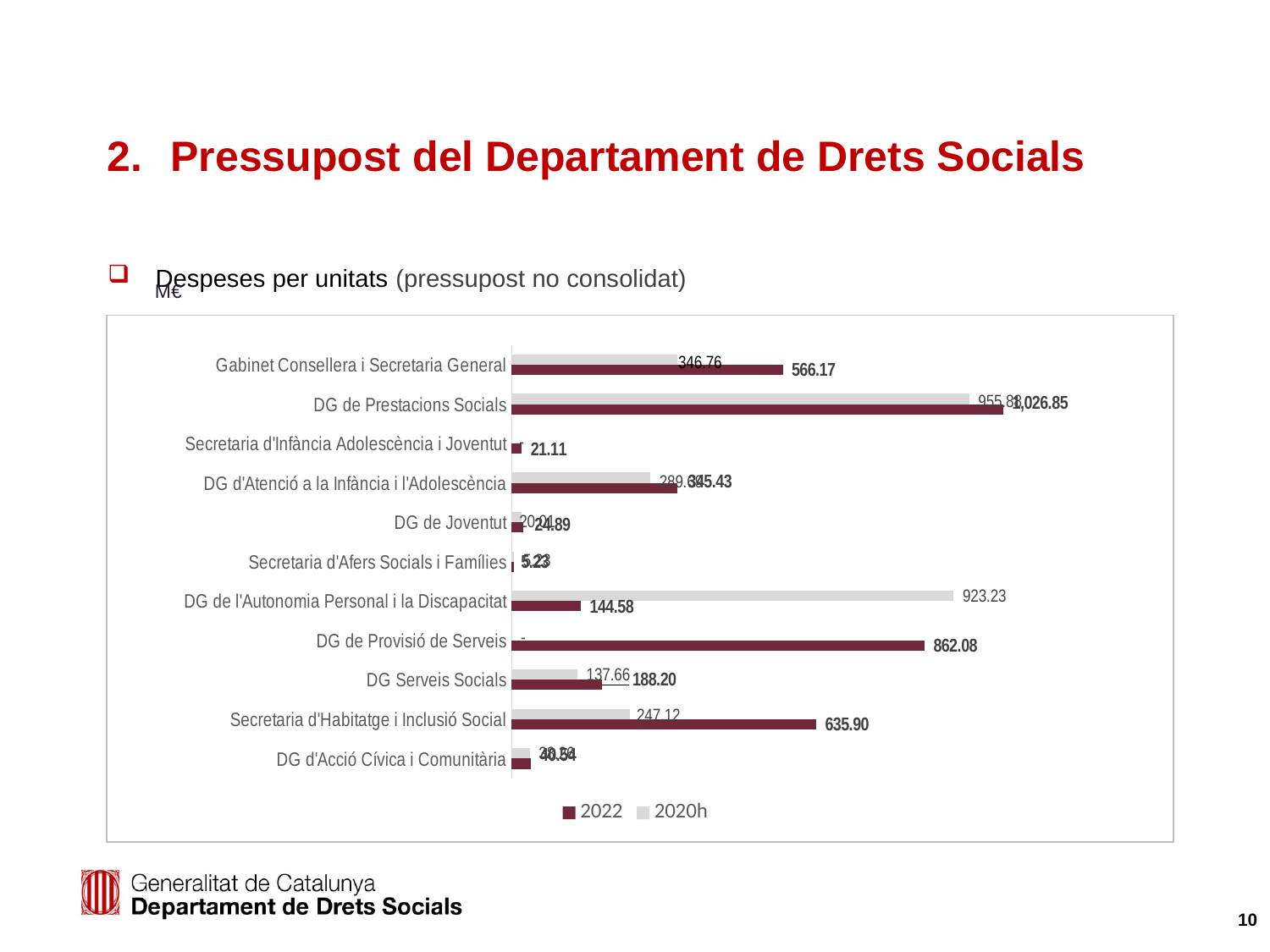
What is the 2020h value for Gabinet Consellera i Secretaria General? 346.76 What is the 2022 value for DG de Provisió de Serveis? 862.08 What is the 2020h value for DG de l'Autonomia Personal i la Discapacitat? 923.23 How many series does the legend list? 2 How many units (categories) are shown on the chart? 11 What is the difference between the 2022 and 2020h values for DG Serveis Socials? 50.54 For DG de l'Autonomia Personal i la Discapacitat, which series has the larger value, 2022 or 2020h? 2020h What is the 2022 value for DG de Prestacions Socials? 1,026.85 Which unit has the highest 2022 value? DG de Prestacions Socials What is the 2022 value for Secretaria d'Habitatge i Inclusió Social? 635.90 What is the difference between the 2022 and 2020h values for Gabinet Consellera i Secretaria General? 219.41 What is the 2022 value for Gabinet Consellera i Secretaria General? 566.17